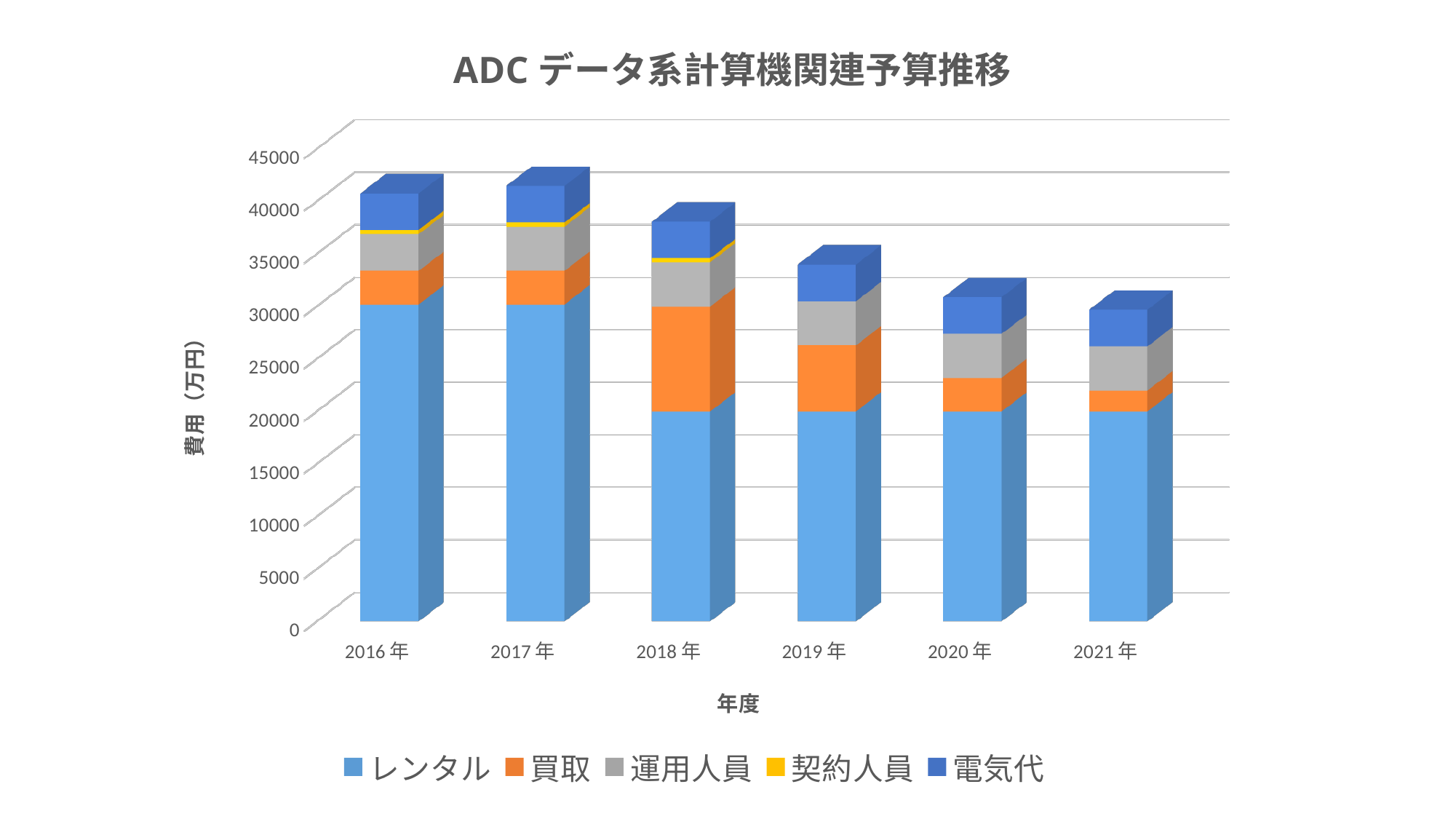
What is the title of the chart? ADC データ系計算機関連予算推移 Is the レンタル value for 2021年 greater or less than 25000? less Do the total budget values generally rise or fall from 2016年 to 2021年? Fall Is the total budget for 2016年 greater or less than 35000? greater Is the total budget for 2021年 greater or less than 35000? less What kind of chart is shown on the slide? Stacked bar chart What is the label of the y axis? 費用（万円） How many years (categories) are shown on the x axis? 6 Which is larger, the total budget for 2016年 or for 2021年? 2016年 Which year has the lowest total budget? 2021年 Which year has the larger 買取 segment, 2016年 or 2018年? 2018年 How many series does the legend list? 5